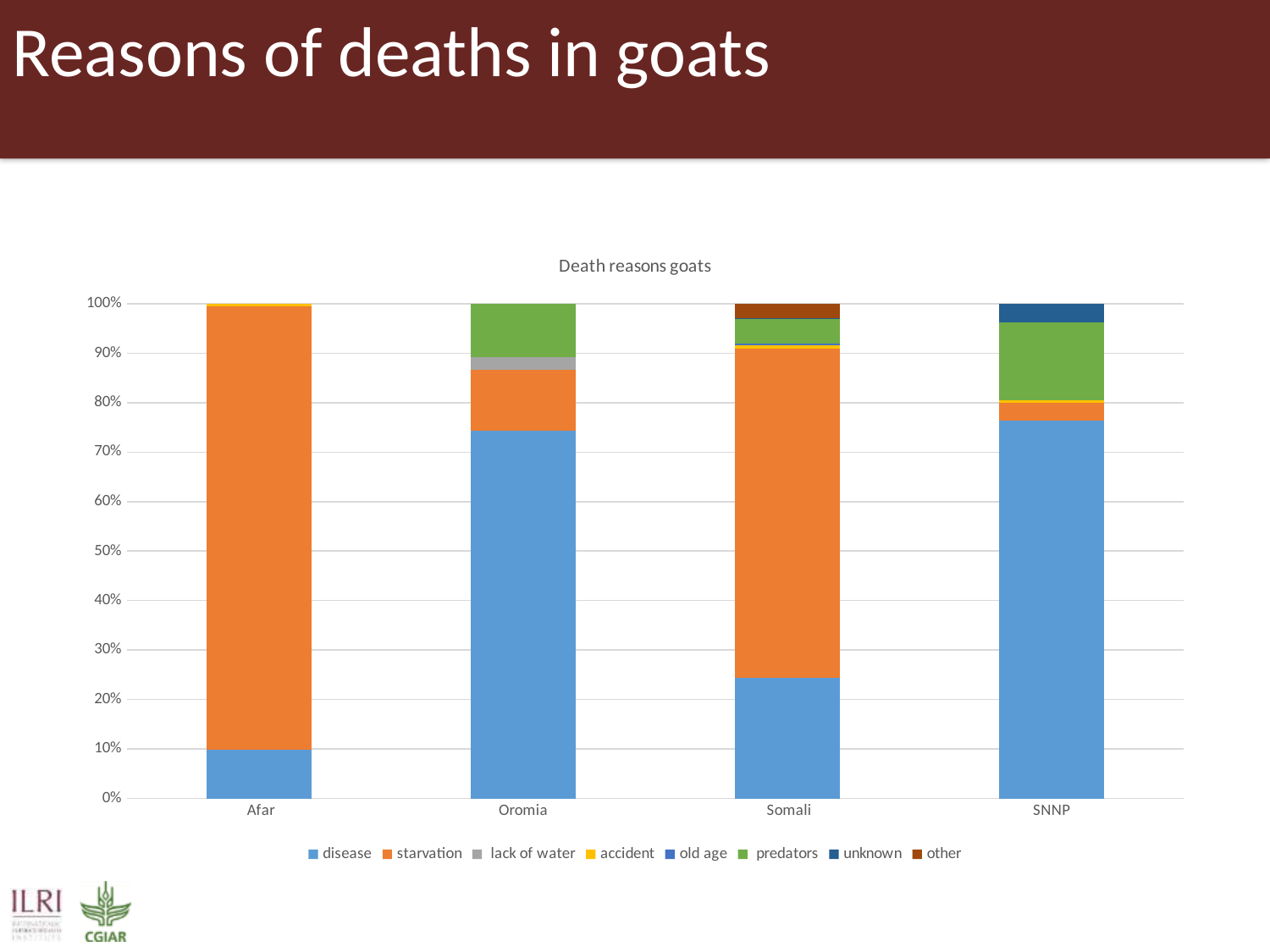
Is the share of deaths due to disease larger in Somali or in Afar? Somali Which region has the smallest share of deaths due to disease? Afar Which region is the only one with an 'other' segment in its bar? Somali Which region has the largest share of deaths due to predators? SNNP Which region has the largest share of deaths due to starvation? Afar How many regions are shown on the x axis of the chart? 4 Is the share of deaths due to disease in Somali greater or less than 30%? less How many series does the legend list? 8 Is the share of deaths due to starvation in Afar greater or less than 80%? greater What kind of chart is shown on the slide? Stacked bar chart Is the share of deaths due to disease in Oromia greater or less than 70%? greater What is the title of the chart? Death reasons goats